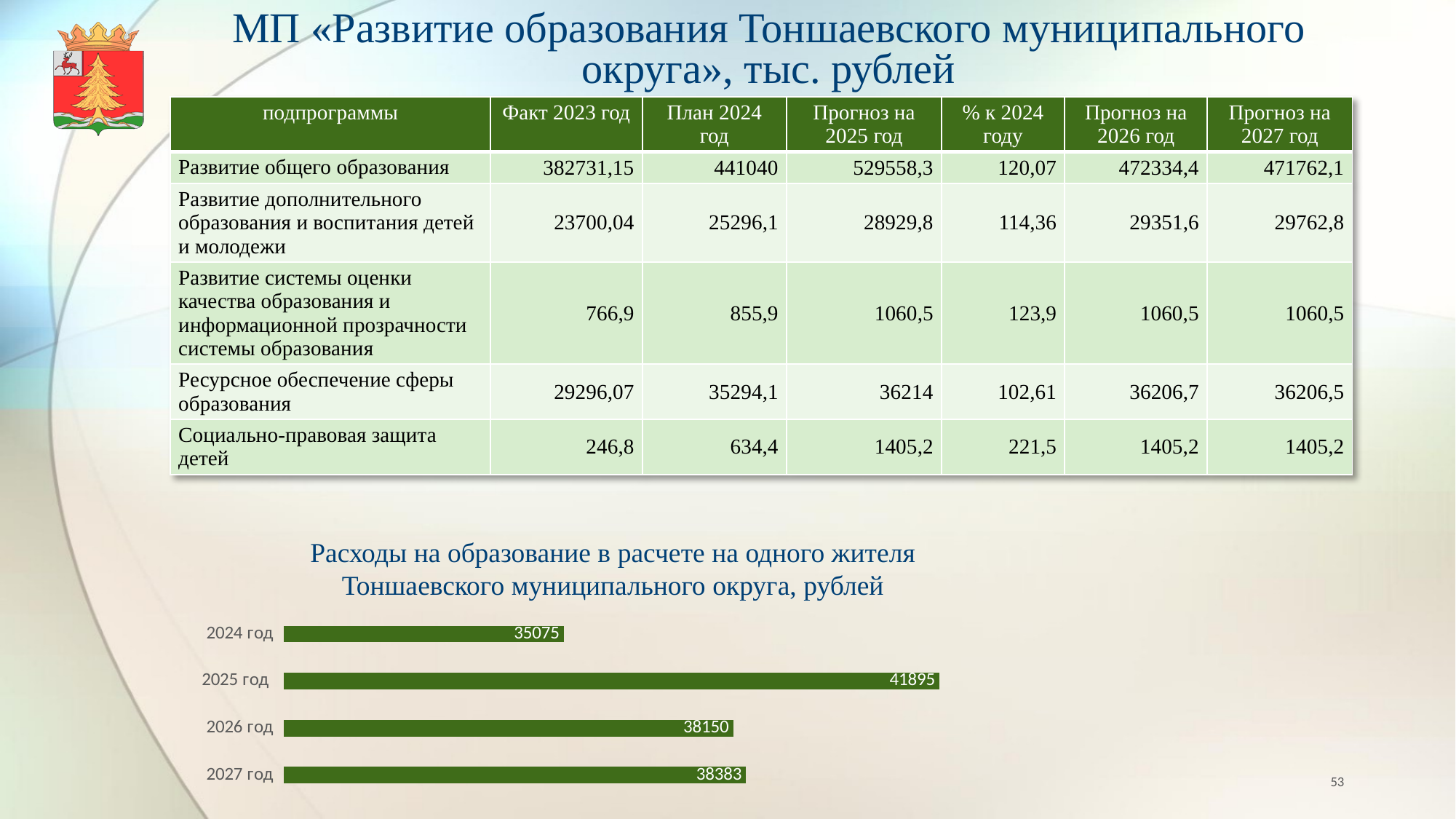
What type of chart is 'Расходы на образование в расчете на одного жителя Тоншаевского муниципального округа, рублей'? bar chart What is the value for 2025 год in the chart 'Расходы на образование в расчете на одного жителя Тоншаевского муниципального округа, рублей'? 41895 How many bars are shown in the chart 'Расходы на образование в расчете на одного жителя'? 4 In the chart 'Расходы на образование в расчете на одного жителя', what is the difference between the values for 2025 год and 2024 год? 6820 In the chart 'Расходы на образование в расчете на одного жителя', which is larger: the value for 2025 год or the value for 2026 год? 2025 год What is the value for 2024 год in the chart 'Расходы на образование в расчете на одного жителя'? 35075 In the chart 'Расходы на образование в расчете на одного жителя', which year has the lowest value? 2024 год What is the value for 2026 год in the chart 'Расходы на образование в расчете на одного жителя'? 38150 In the chart 'Расходы на образование в расчете на одного жителя', which year has the highest value? 2025 год In the chart 'Расходы на образование в расчете на одного жителя', what is the difference between the values for 2027 год and 2026 год? 233 What is the value for 2027 год in the chart 'Расходы на образование в расчете на одного жителя'? 38383 In the chart 'Расходы на образование в расчете на одного жителя', does the value rise or fall from 2024 год to 2025 год? rise